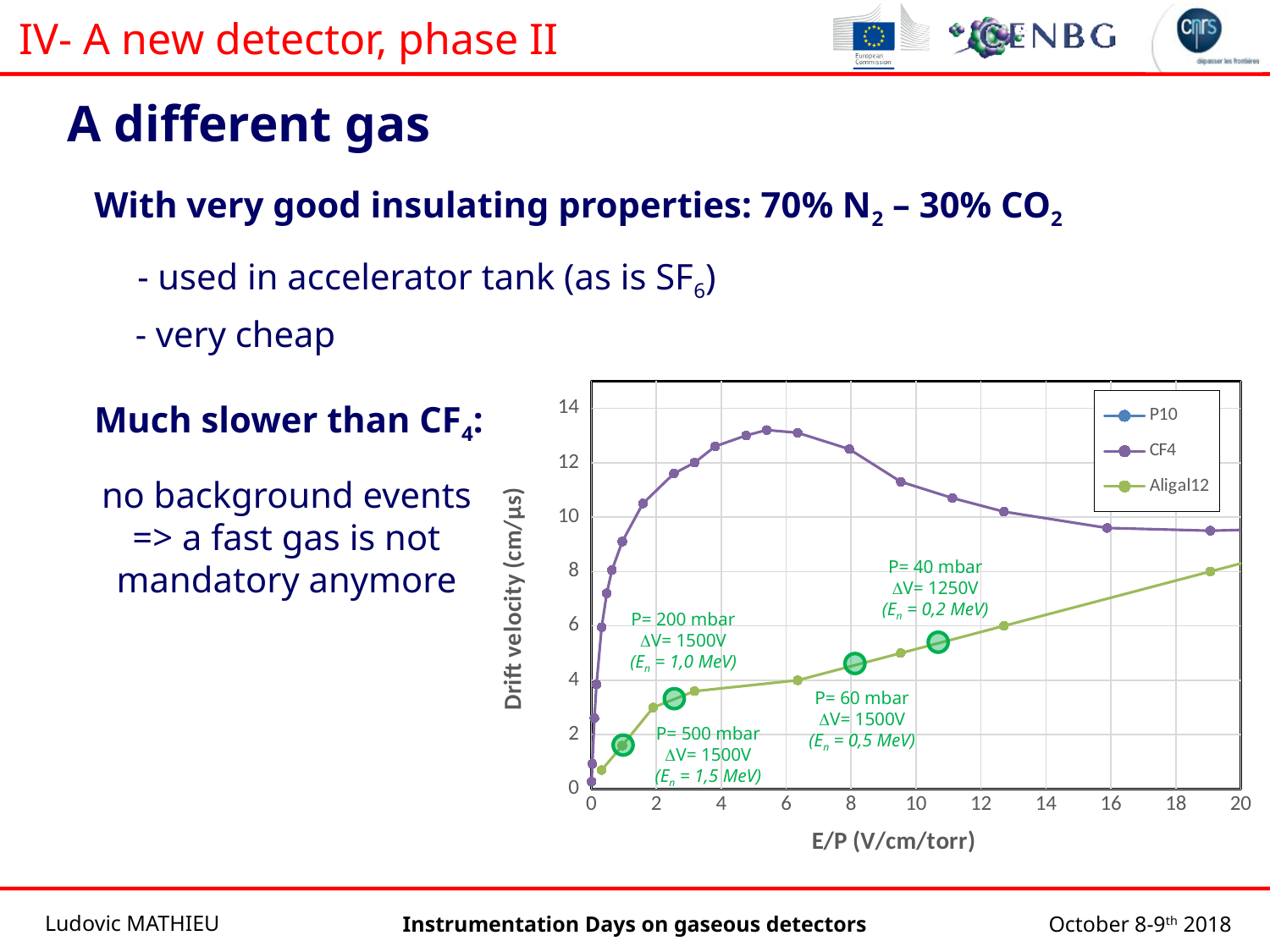
Is the drift velocity of Aligal12 at E/P = 4 V/cm/torr greater or less than 6 cm/µs? less At E/P = 10 V/cm/torr, which series has the higher drift velocity, CF4 or Aligal12? CF4 Is the drift velocity of Aligal12 at E/P = 19 V/cm/torr greater or less than 6 cm/µs? greater Does the CF4 drift velocity rise or fall as E/P increases from 6 to 16 V/cm/torr? fall What are the series names listed in the chart legend? P10, CF4, Aligal12 What kind of chart is shown on the slide? line chart How many series does the chart legend list? 3 Is the drift velocity of CF4 at E/P = 19 V/cm/torr greater or less than 10 cm/µs? less What is the title of the chart's y axis? Drift velocity (cm/µs) Does the Aligal12 drift velocity rise or fall as E/P increases from 0 to 20 V/cm/torr? rise Which series reaches the highest drift velocity on the chart? CF4